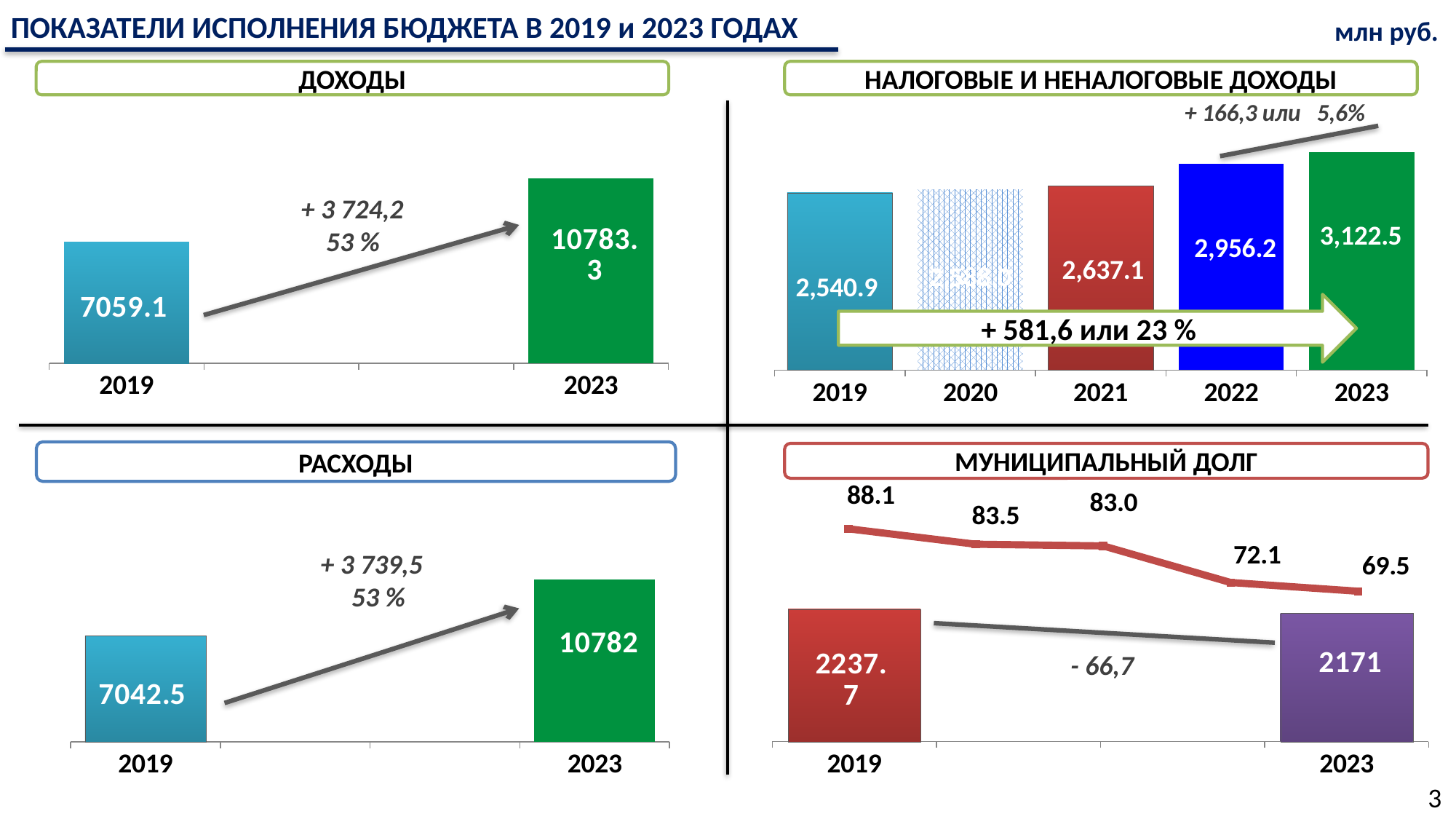
In the НАЛОГОВЫЕ И НЕНАЛОГОВЫЕ ДОХОДЫ chart, how many years are shown on the x axis? 5 What type of chart is the ДОХОДЫ chart? bar chart In the НАЛОГОВЫЕ И НЕНАЛОГОВЫЕ ДОХОДЫ chart, what is the difference between the 2023 and 2022 values? 166.3 In the РАСХОДЫ chart, what is the value for 2019? 7042.5 In the НАЛОГОВЫЕ И НЕНАЛОГОВЫЕ ДОХОДЫ chart, which year has the highest value? 2023 In the МУНИЦИПАЛЬНЫЙ ДОЛГ chart, do the values of the line rise or fall from left to right? fall In the МУНИЦИПАЛЬНЫЙ ДОЛГ chart, what is the bar value for 2023? 2171 In the ДОХОДЫ chart, what is the value for 2023? 10783.3 In the ДОХОДЫ chart, what is the difference between the 2023 and 2019 values? 3724.2 In the РАСХОДЫ chart, which year has the larger value, 2019 or 2023? 2023 In the НАЛОГОВЫЕ И НЕНАЛОГОВЫЕ ДОХОДЫ chart, what is the value for 2022? 2,956.2 In the МУНИЦИПАЛЬНЫЙ ДОЛГ chart, what is the difference between the 2019 and 2023 bar values? 66.7